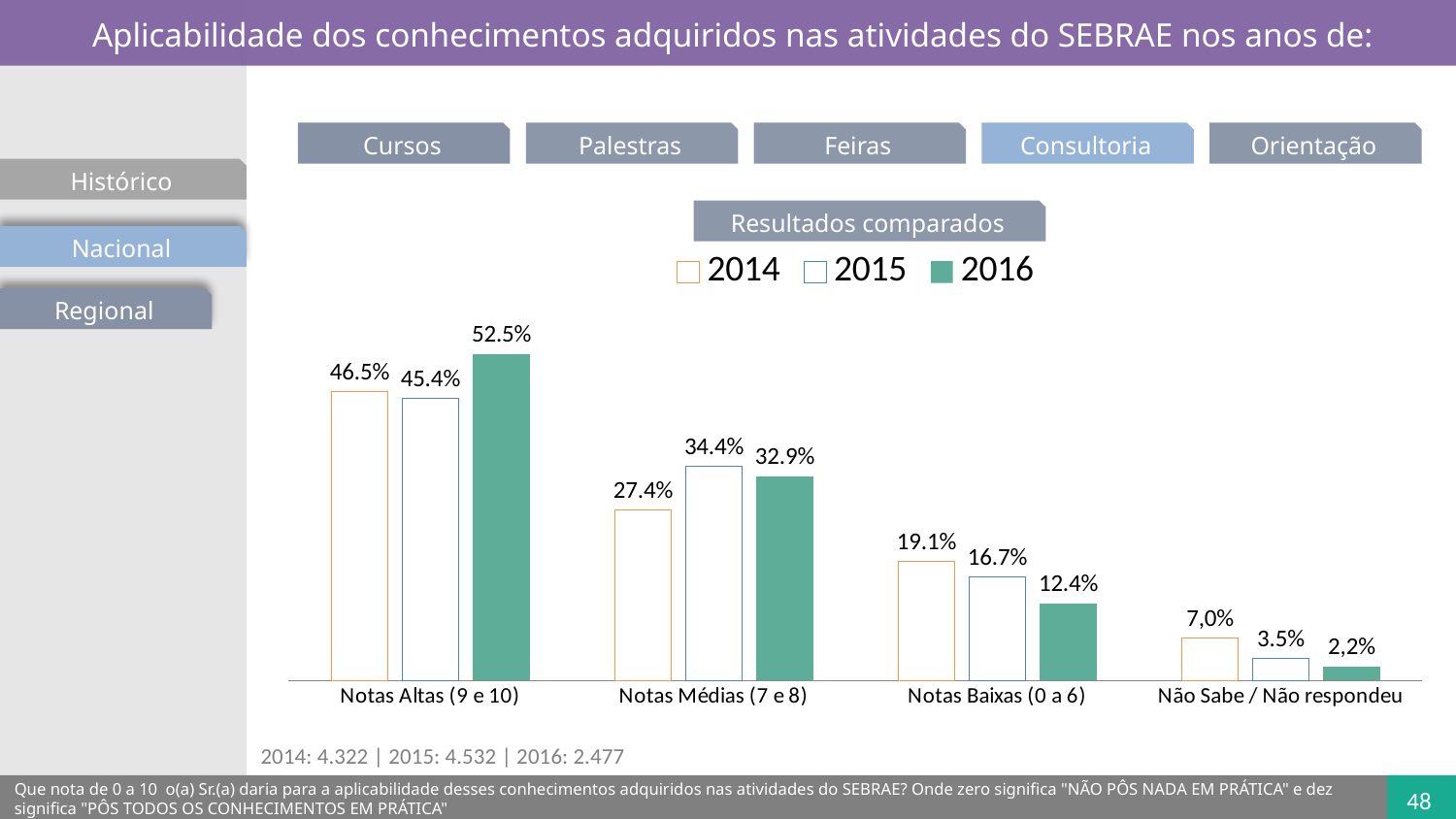
How many categories are shown on the x axis of the chart? 4 How many series does the chart legend list? 3 In the Notas Médias (7 e 8) category, which is larger: the 2015 value or the 2016 value? 2015 What is the difference between the 2016 and 2014 values in the Notas Altas (9 e 10) category? 6.0 percentage points Which category has the lowest value for the 2015 series? Não Sabe / Não respondeu Which category has the highest value for the 2016 series? Notas Altas (9 e 10) What is the value for 2015 in the Notas Baixas (0 a 6) category? 16.7% What kind of chart is shown on the slide? Bar chart What is the value for 2014 in the Notas Médias (7 e 8) category? 27.4% What is the value for 2014 in the Não Sabe / Não respondeu category? 7,0% What is the value for 2016 in the Notas Altas (9 e 10) category? 52.5% What is the difference between the 2014 and 2016 values in the Notas Baixas (0 a 6) category? 6.7 percentage points